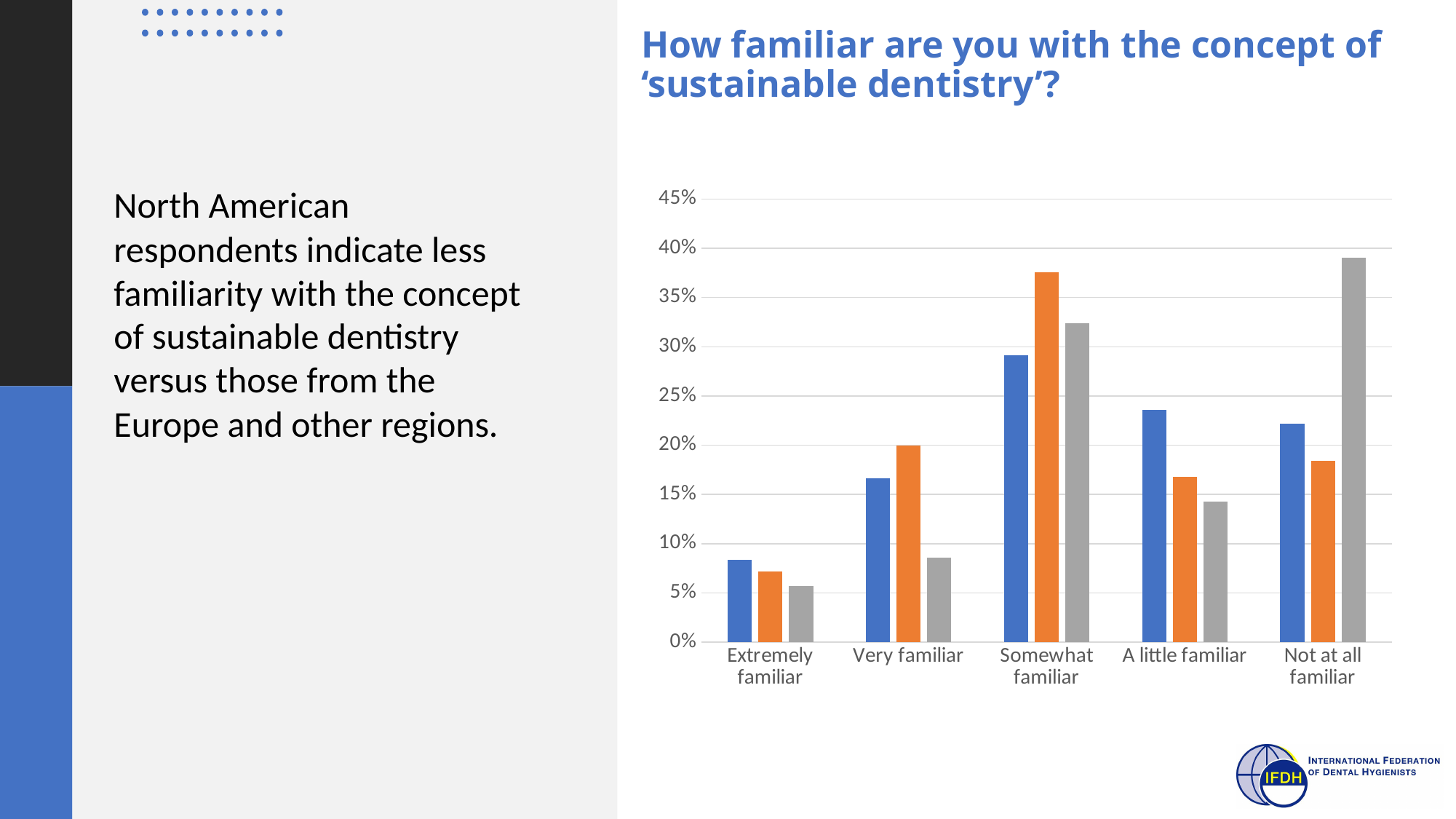
What kind of chart is shown on the slide? bar chart For the blue bars, which category has the lowest value? Extremely familiar For the gray bars, which category has the lowest value? Extremely familiar In the 'Somewhat familiar' category, which is larger, the orange bar or the gray bar? the orange bar For the orange bars, which category has the highest value? Somewhat familiar How many bars are plotted for each category in the chart? 3 In the 'Not at all familiar' category, which is larger, the blue bar or the orange bar? the blue bar How many familiarity categories are shown on the x axis of the chart? 5 Is the gray bar for 'Not at all familiar' greater or less than 35%? greater Is the blue bar for 'Extremely familiar' greater or less than 10%? less For the gray bars, which category has the highest value? Not at all familiar What is the title of the chart? How familiar are you with the concept of 'sustainable dentistry'?